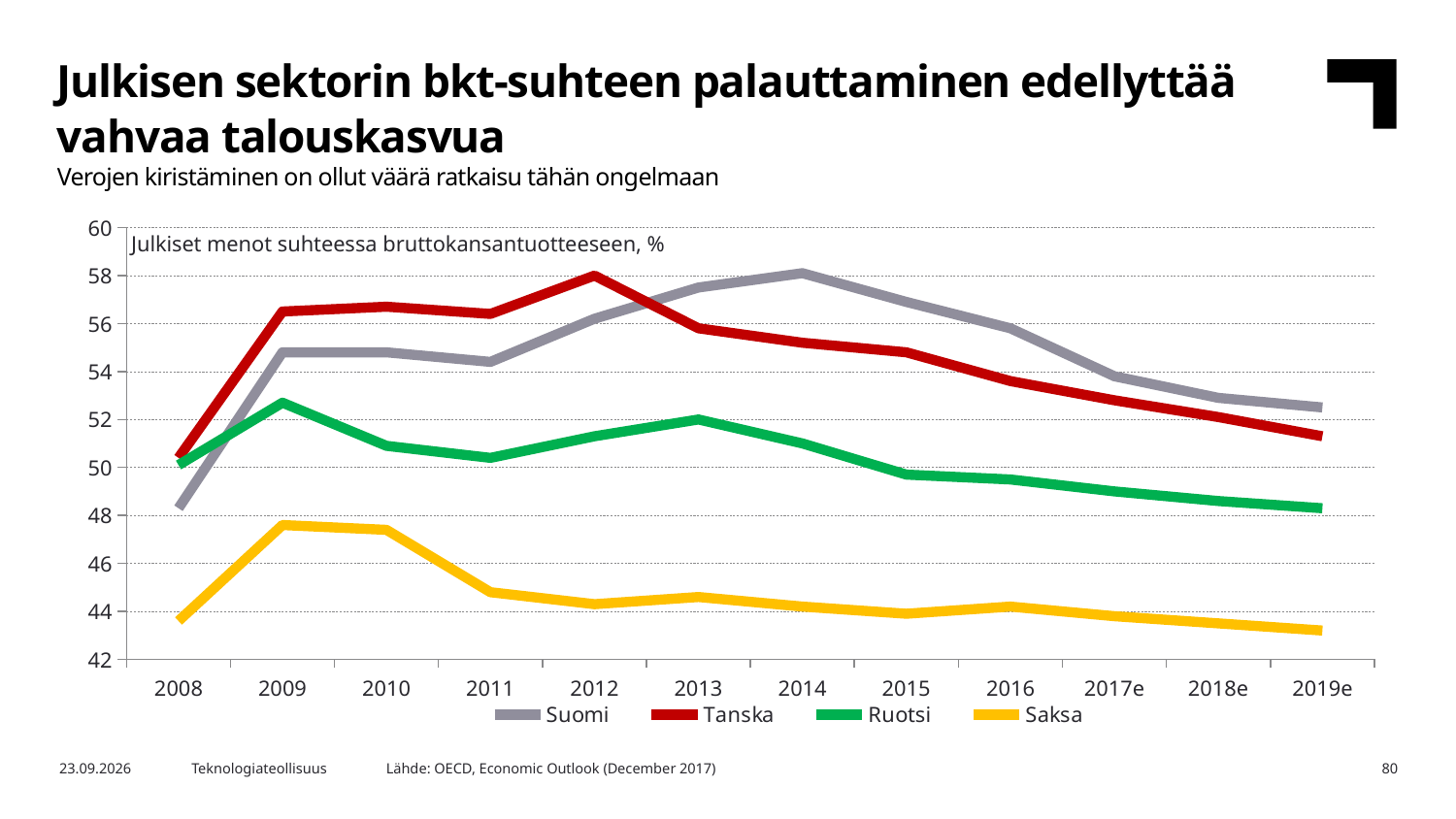
Is the value for Saksa in 2009 greater or less than 46? greater Is the value for Ruotsi in 2019e greater or less than 50? less What is the label shown inside the chart area describing what is plotted? Julkiset menot suhteessa bruttokansantuotteeseen, % Does the value for Ruotsi rise or fall from 2013 to 2019e? fall Which series has the highest value in 2019e? Suomi How many series does the legend list? 4 What kind of chart is shown on the slide? line chart Which series has the lowest value in 2012? Saksa Is the value for Suomi in 2008 greater or less than 50? less Which is larger in 2012, the value for Tanska or the value for Suomi? Tanska How many years are shown on the x axis? 12 In which year does Tanska reach its highest value? 2012